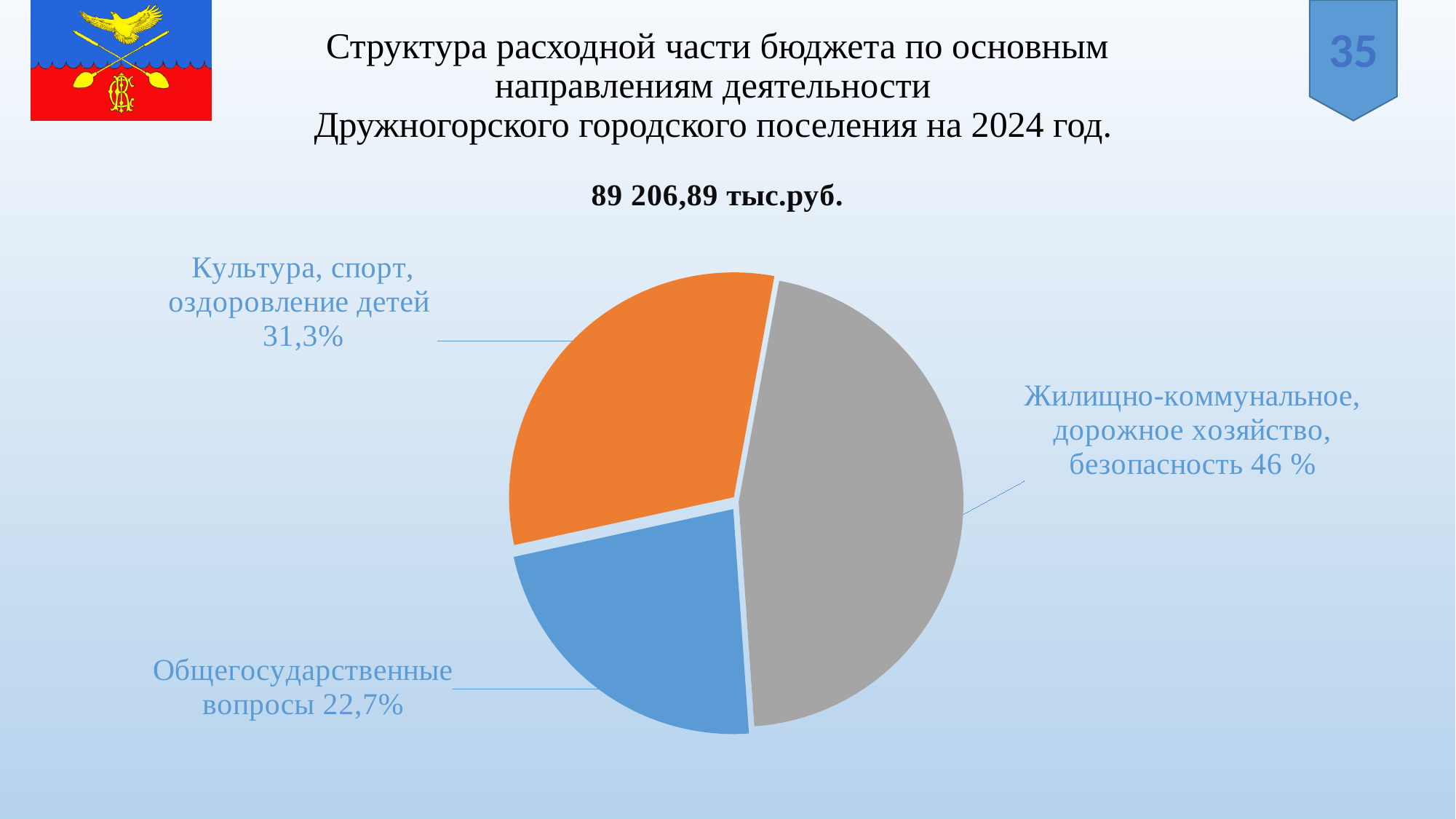
How many slices does the pie chart have? 3 What share of the pie is labelled "Жилищно-коммунальное, дорожное хозяйство, безопасность"? 46 % Which slice of the pie is the smallest? Общегосударственные вопросы Which is larger: the share for "Культура, спорт, оздоровление детей" or the share for "Общегосударственные вопросы"? Культура, спорт, оздоровление детей What share of the pie is labelled "Культура, спорт, оздоровление детей"? 31,3% What is the difference in percentage points between the "Культура, спорт, оздоровление детей" slice and the "Общегосударственные вопросы" slice? 8,6 What colour is the slice for "Общегосударственные вопросы"? blue What share of the pie is labelled "Общегосударственные вопросы"? 22,7% Which slice of the pie is the largest? Жилищно-коммунальное, дорожное хозяйство, безопасность What total amount in thousand roubles is shown above the pie chart? 89 206,89 тыс.руб. What kind of chart is shown on the slide? pie chart